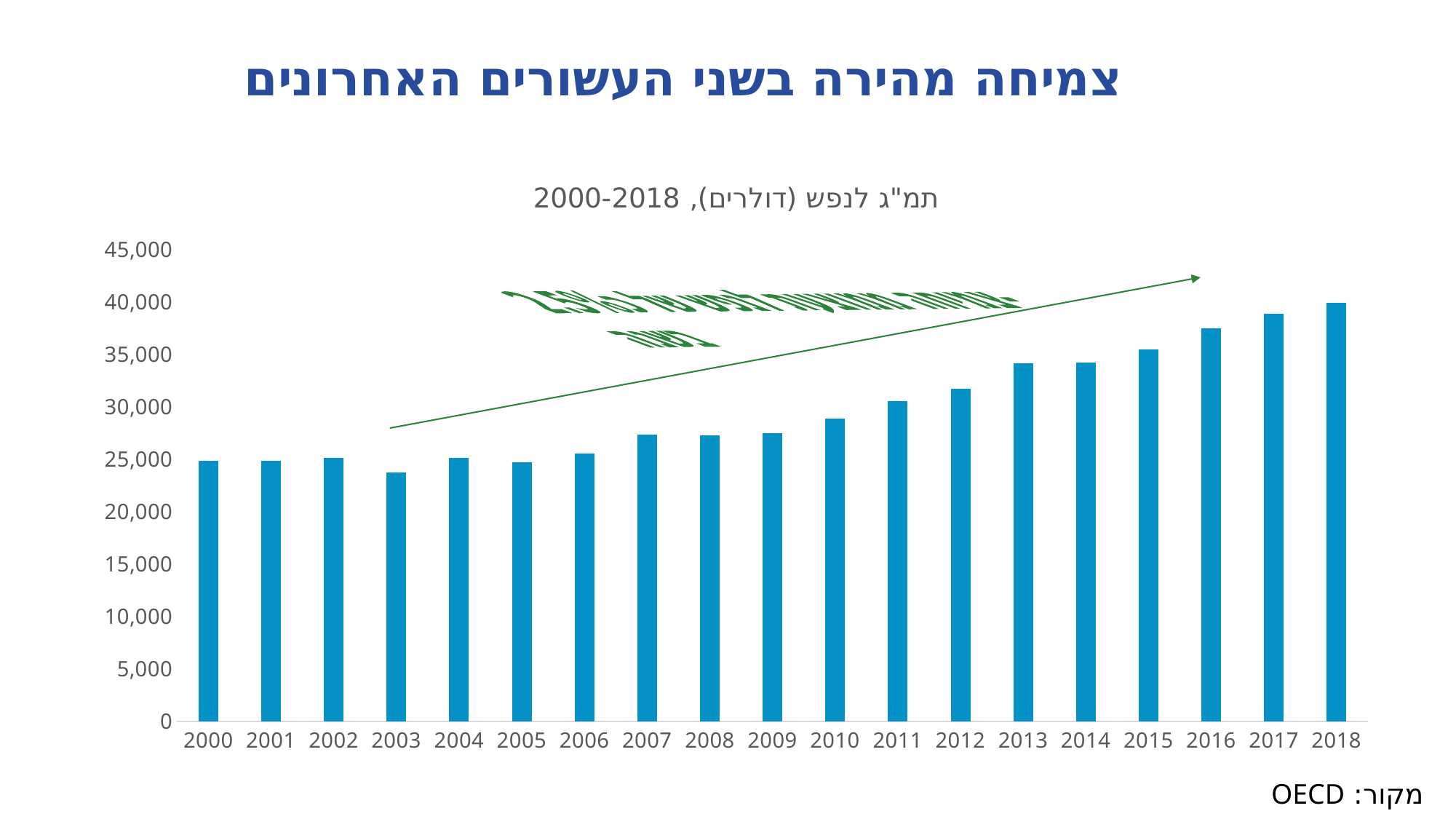
Which year has the larger value, 2003 or 2007? 2007 How many years (bars) are plotted in the chart? 19 Which year has the lowest value in the chart? 2003 Is the value for 2016 greater or less than 35,000? greater Which year has the larger value, 2000 or 2018? 2018 Is the value for 2013 greater or less than 30,000? greater What source is cited for the chart data? OECD Which year has the highest value in the chart? 2018 Do the values generally rise or fall from 2000 to 2018? rise What kind of chart is shown on the slide? bar chart Is the value for 2003 greater or less than 25,000? less